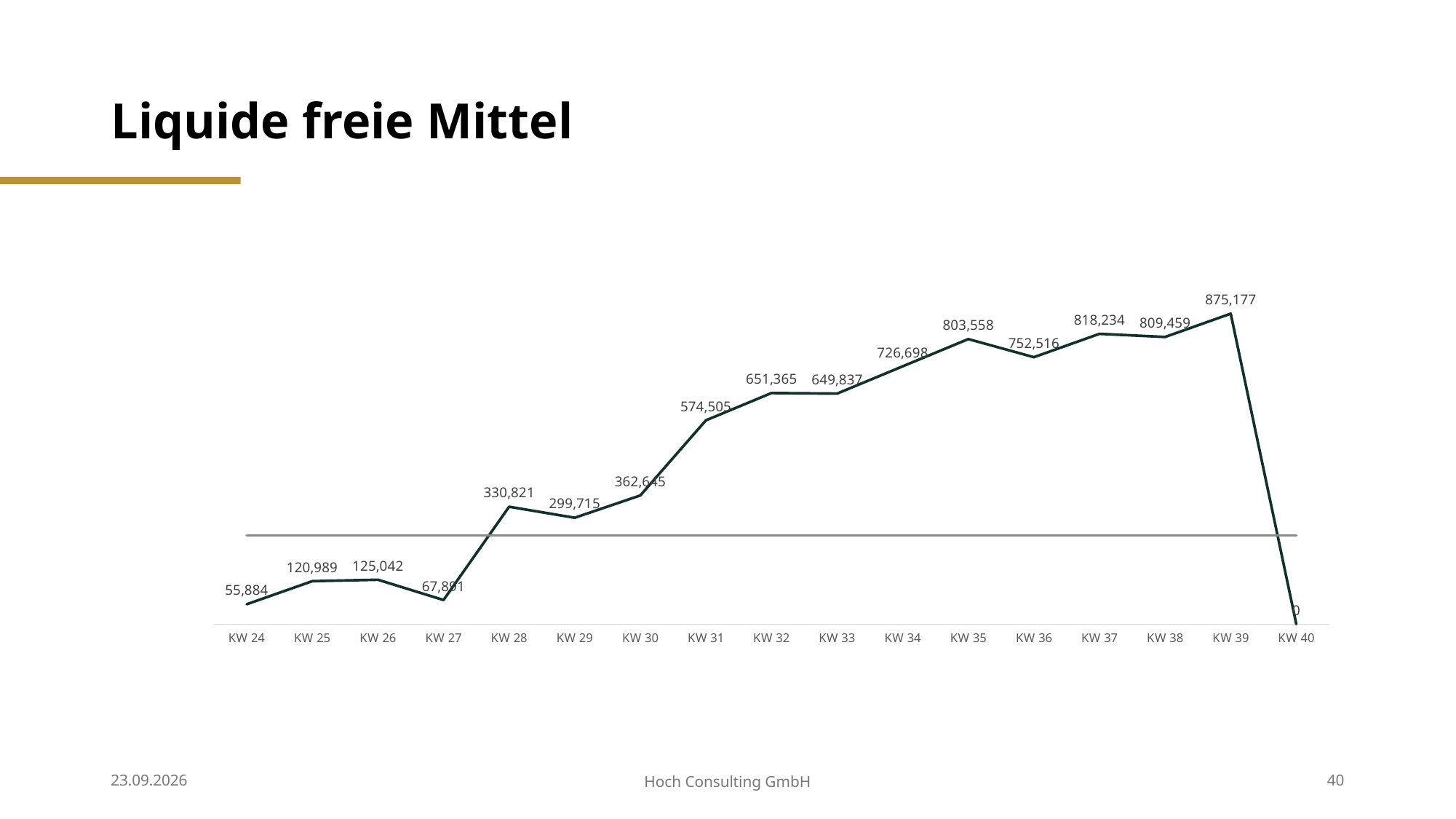
What is the title of the chart? Liquide freie Mittel What is the value for KW 39? 875,177 How many weeks are shown on the x axis? 17 What is the value for KW 24? 55,884 Which week has the lowest value? KW 40 What is the difference between the values for KW 39 and KW 38? 65,718 Which is larger, the value for KW 28 or the value for KW 29? KW 28 What is the difference between the values for KW 35 and KW 36? 51,042 What is the value for KW 36? 752,516 What is the value for KW 32? 651,365 Which week has the highest value? KW 39 What type of chart is shown on the slide? line chart